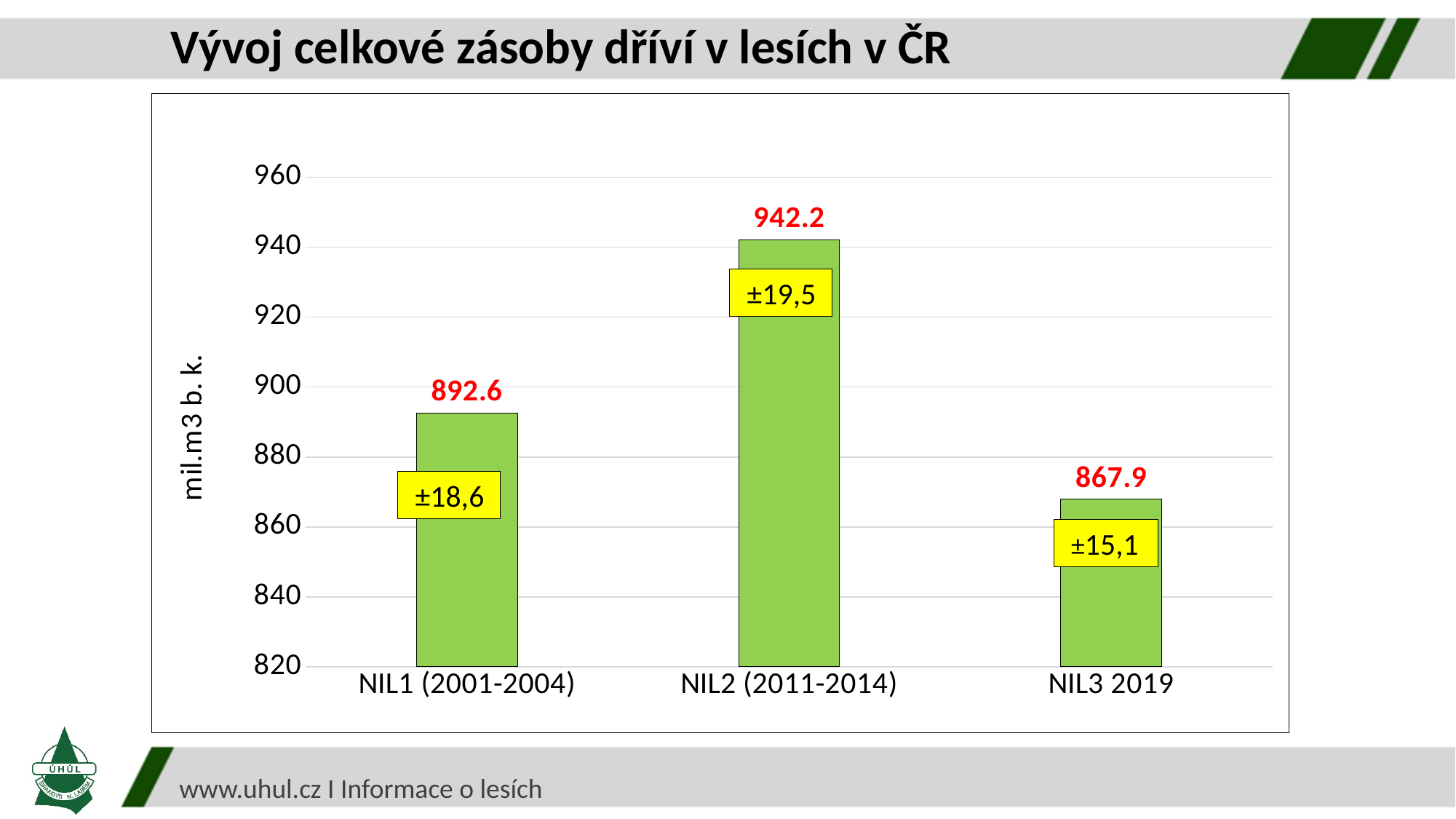
What kind of chart is shown on the slide? bar chart What is the value for NIL3 2019? 867.9 How many categories are shown on the x axis? 3 What is the difference between the values for NIL2 (2011-2014) and NIL1 (2001-2004)? 49.6 What is the value for NIL1 (2001-2004)? 892.6 What is the difference between the values for NIL1 (2001-2004) and NIL3 2019? 24.7 Which category has the lowest value? NIL3 2019 What is the value for NIL2 (2011-2014)? 942.2 What is the uncertainty label shown on the bar for NIL2 (2011-2014)? ±19,5 Which category has the highest value? NIL2 (2011-2014) Is the value for NIL2 (2011-2014) greater or less than 920? greater Which is larger, the value for NIL1 (2001-2004) or NIL3 2019? NIL1 (2001-2004)